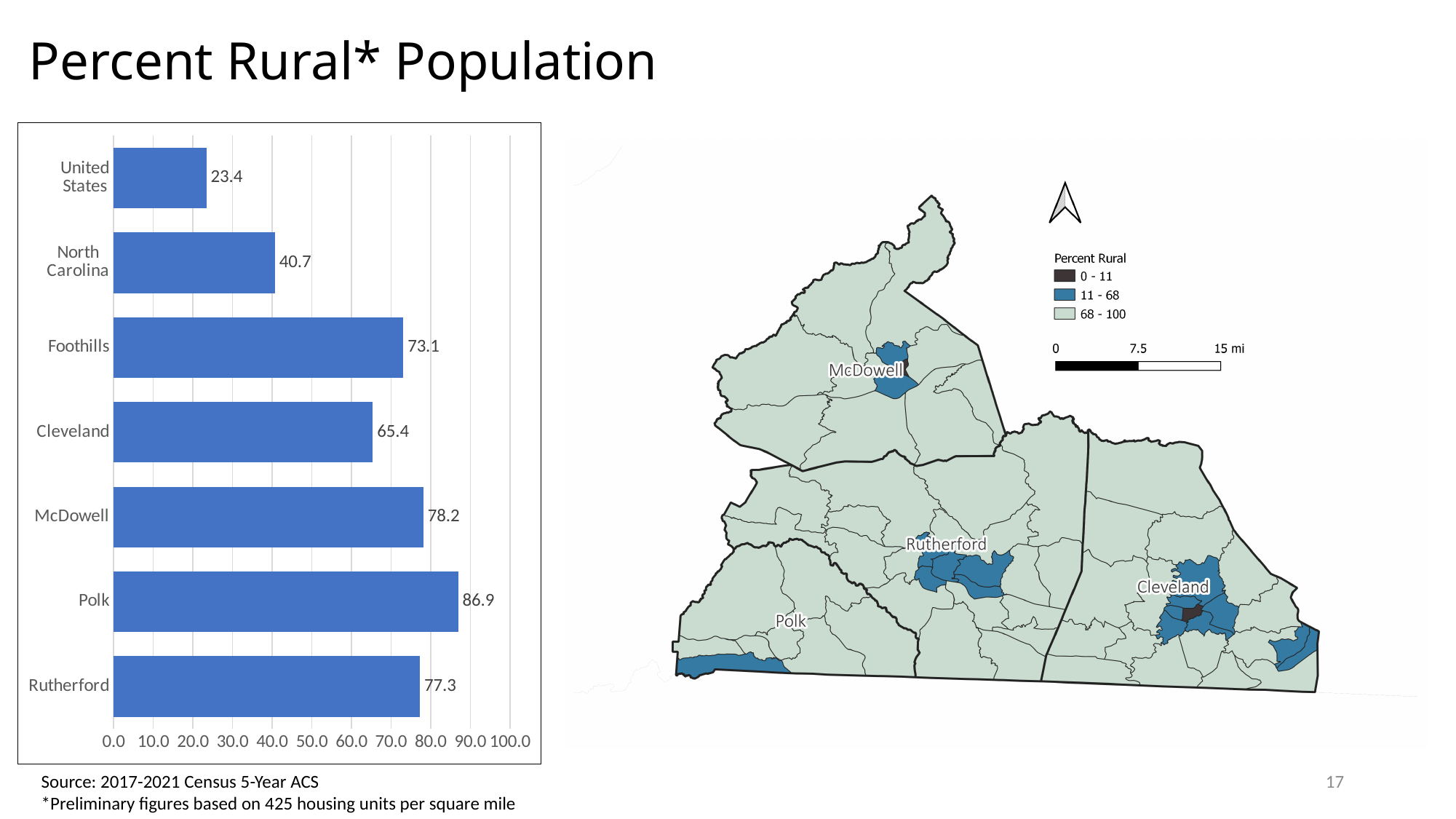
What is the percent rural population value for Foothills? 73.1 What is the maximum value shown on the x axis of the bar chart? 100.0 What is the difference between the values for North Carolina and the United States? 17.3 Which has a larger percent rural population, Cleveland or McDowell? McDowell What is the difference between the values for McDowell and Rutherford? 0.9 What is the percent rural population value for the United States? 23.4 Which category has the highest percent rural population? Polk Is the value for Cleveland greater or less than 70.0? less What is the percent rural population value for Polk? 86.9 What kind of chart is shown on the left of the slide? Bar chart How many categories are shown in the bar chart? 7 Which category has the lowest percent rural population? United States